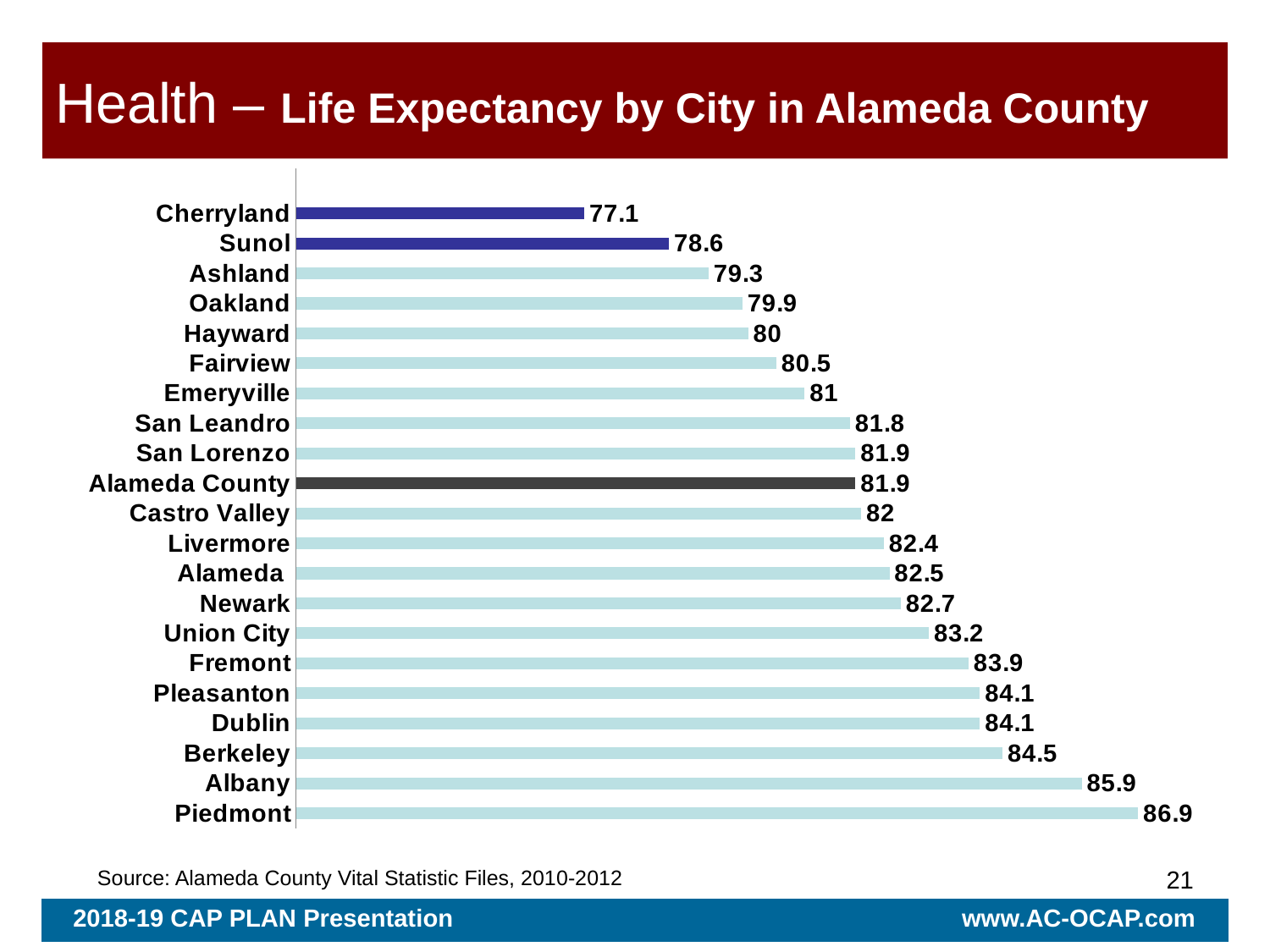
Which bar on the chart is drawn in dark grey rather than light blue? Alameda County Which has a higher life expectancy, Sunol or Emeryville? Emeryville What is the difference between the life expectancy of Piedmont and Cherryland? 9.8 Which has a higher life expectancy, Hayward or Union City? Union City How many bars are shown on the chart? 21 What is the life expectancy value shown for Oakland? 79.9 What is the difference between the life expectancy of Albany and Berkeley? 1.4 What is the life expectancy value shown for Alameda County? 81.9 What kind of chart is shown on the slide? Bar chart Which city has the highest life expectancy on the chart? Piedmont Which city has the lowest life expectancy on the chart? Cherryland What is the life expectancy value shown for Fremont? 83.9